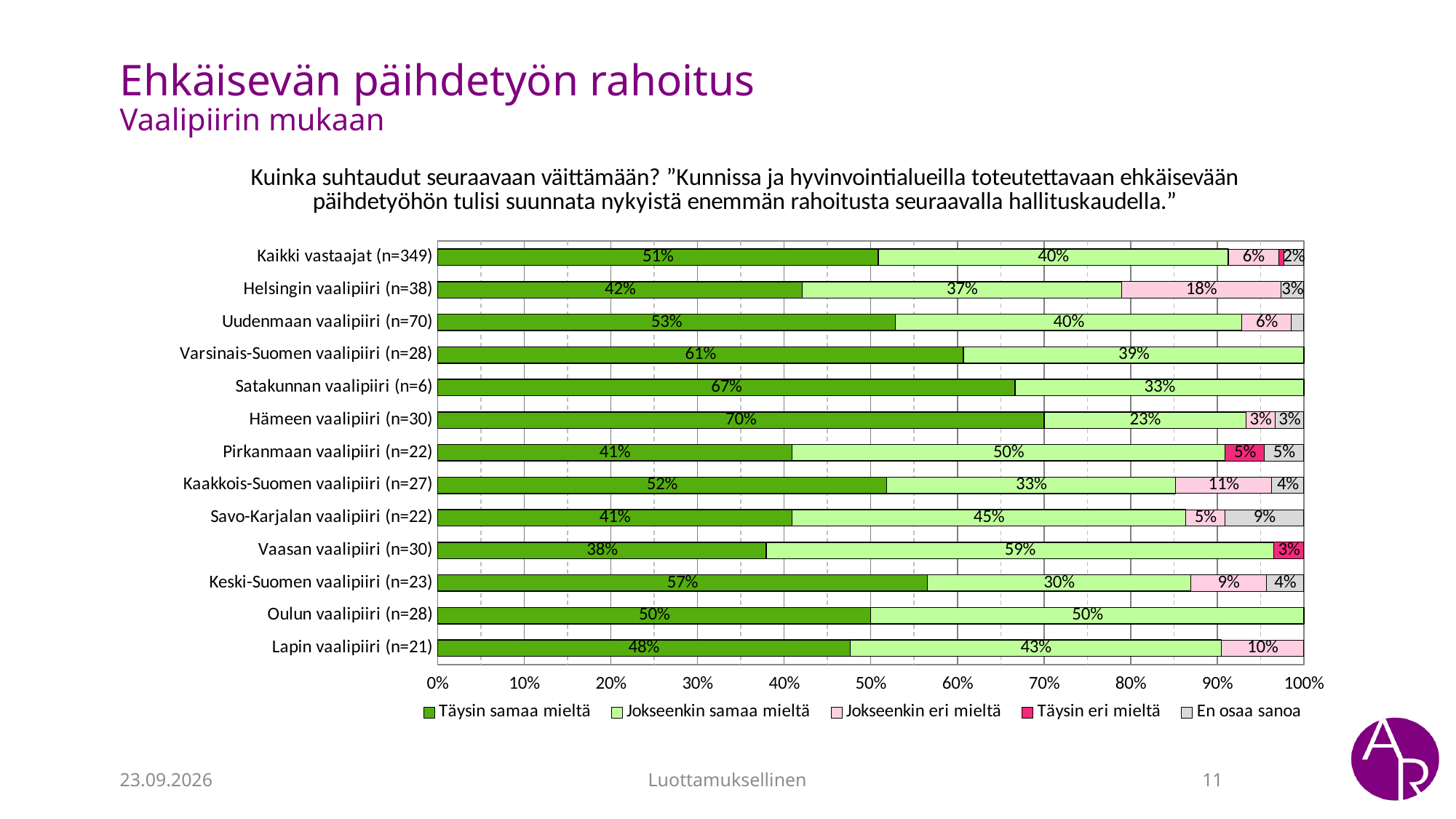
How many series does the legend list? 5 Which category has the lowest 'Täysin samaa mieltä' value? Vaasan vaalipiiri (n=30) What is the difference between the 'Täysin samaa mieltä' values of Satakunnan vaalipiiri (n=6) and Helsingin vaalipiiri (n=38)? 25 percentage points What is the 'Jokseenkin eri mieltä' value for Helsingin vaalipiiri (n=38)? 18% What kind of chart is shown on the slide? Stacked bar chart What is the 'Täysin samaa mieltä' value for Hämeen vaalipiiri (n=30)? 70% Which is larger: the 'Täysin samaa mieltä' value for Keski-Suomen vaalipiiri (n=23) or for Oulun vaalipiiri (n=28)? Keski-Suomen vaalipiiri (n=23) Which category has the highest 'Täysin samaa mieltä' value? Hämeen vaalipiiri (n=30) How many categories (rows) are plotted in the chart? 13 What is the 'En osaa sanoa' value for Savo-Karjalan vaalipiiri (n=22)? 9% What is the 'Jokseenkin samaa mieltä' value for Vaasan vaalipiiri (n=30)? 59% Is the 'Täysin samaa mieltä' value for Varsinais-Suomen vaalipiiri (n=28) greater or less than 50%? greater